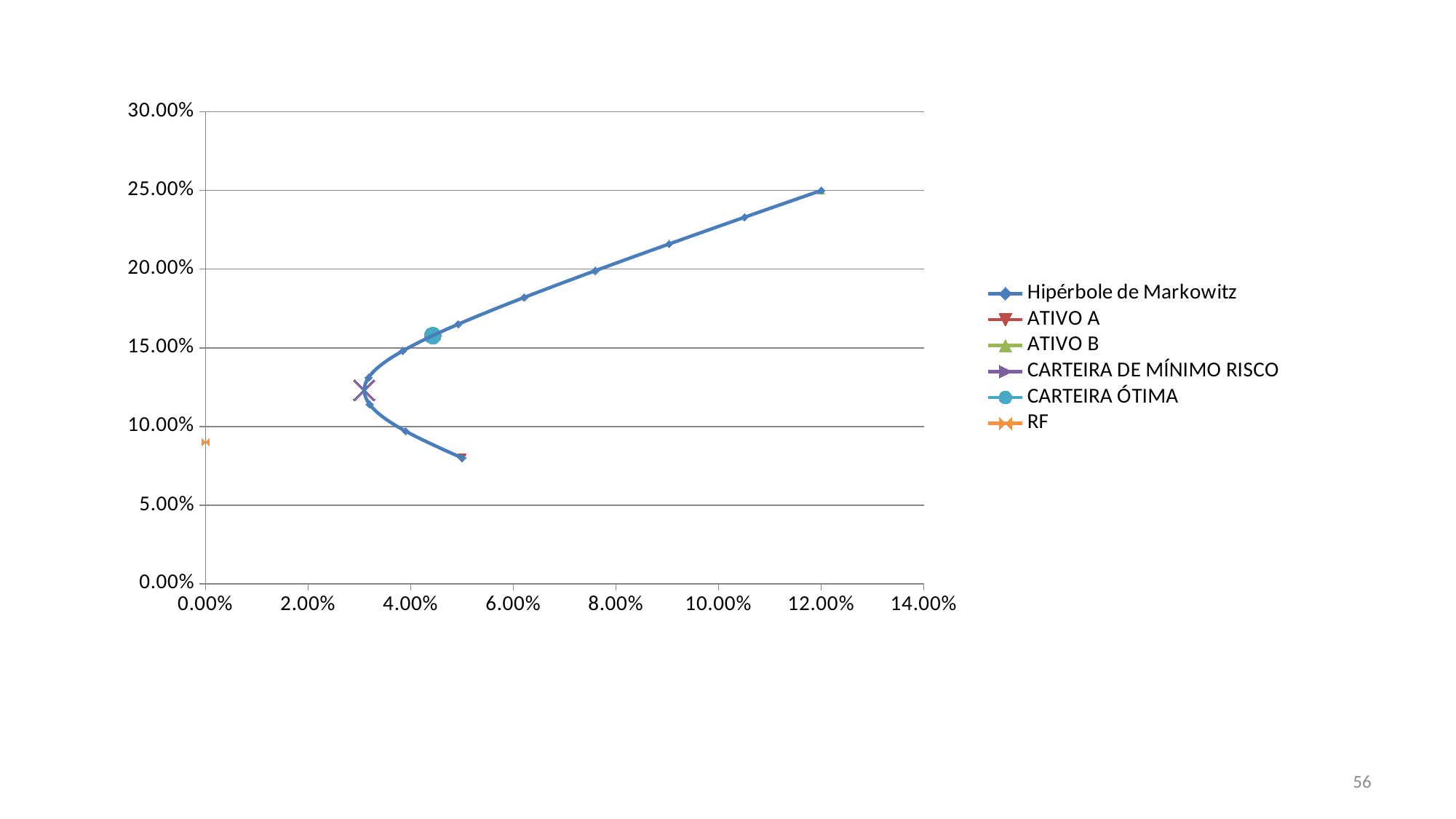
Is the vertical-axis value for CARTEIRA ÓTIMA greater or less than 20.00%? less What is the vertical-axis value of the ATIVO B point? 25.00% Which series is drawn as the curved blue line with diamond markers? Hipérbole de Markowitz Is the vertical-axis value for ATIVO A greater or less than 10.00%? less Is the horizontal-axis value for CARTEIRA DE MÍNIMO RISCO greater or less than 4.00%? less Which has the higher vertical-axis value, ATIVO A or ATIVO B? ATIVO B How many series does the legend list? 6 What kind of chart is shown on the slide? scatter chart What is the highest value shown on the vertical axis? 30.00%